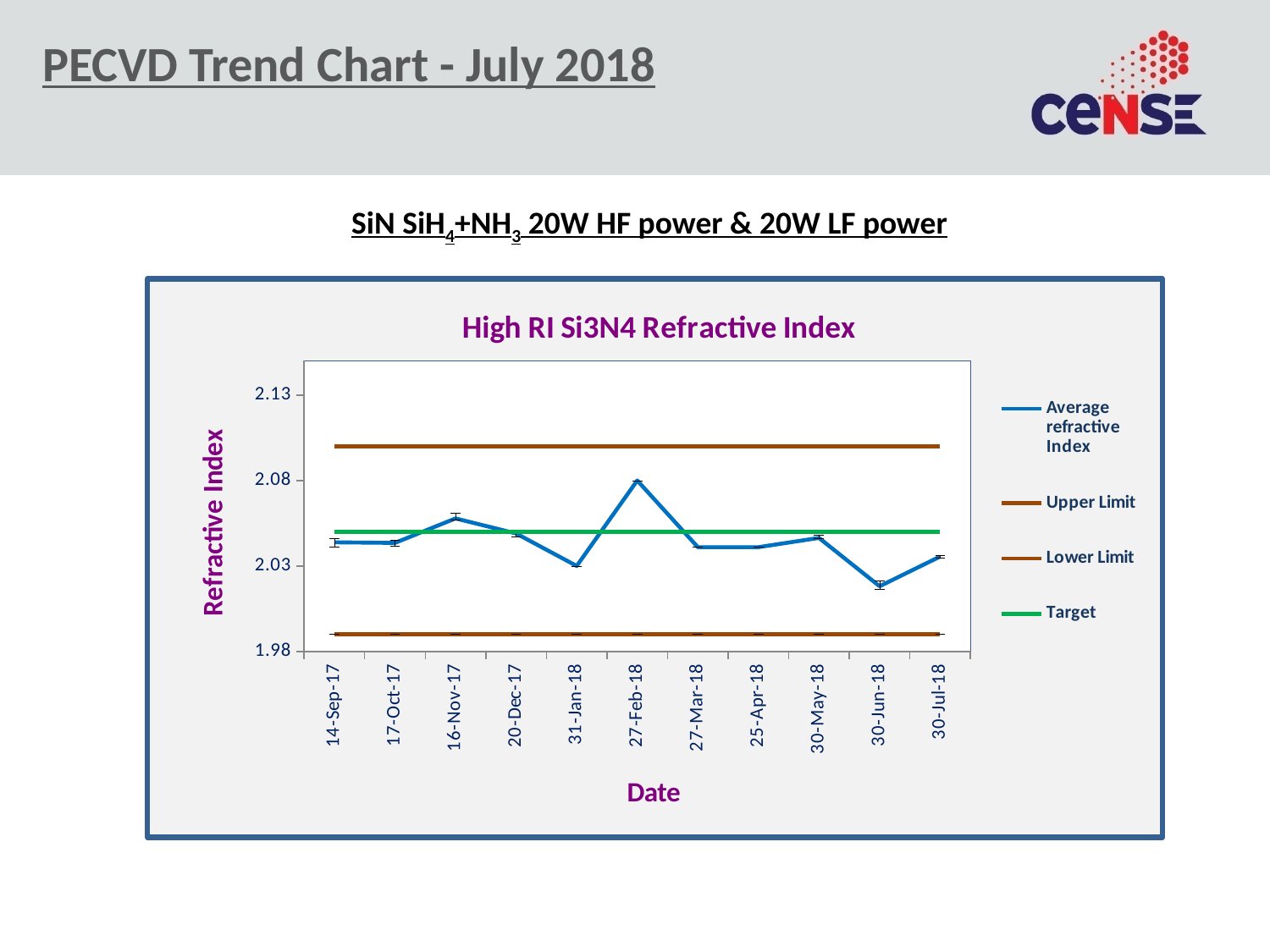
Is the average refractive index for 30-Jun-18 greater or less than 2.03? less Is the Lower Limit line greater or less than 2.03? less Is the Upper Limit line greater or less than 2.08? greater Which is larger, the average refractive index on 16-Nov-17 or on 31-Jan-18? 16-Nov-17 What is the title of the chart? High RI Si3N4 Refractive Index What type of chart is shown on the slide? line chart On which date is the average refractive index highest? 27-Feb-18 Does the average refractive index rise or fall from 27-Feb-18 to 27-Mar-18? fall How many dates are plotted along the x axis? 11 On which date is the average refractive index lowest? 30-Jun-18 How many series does the legend list? 4